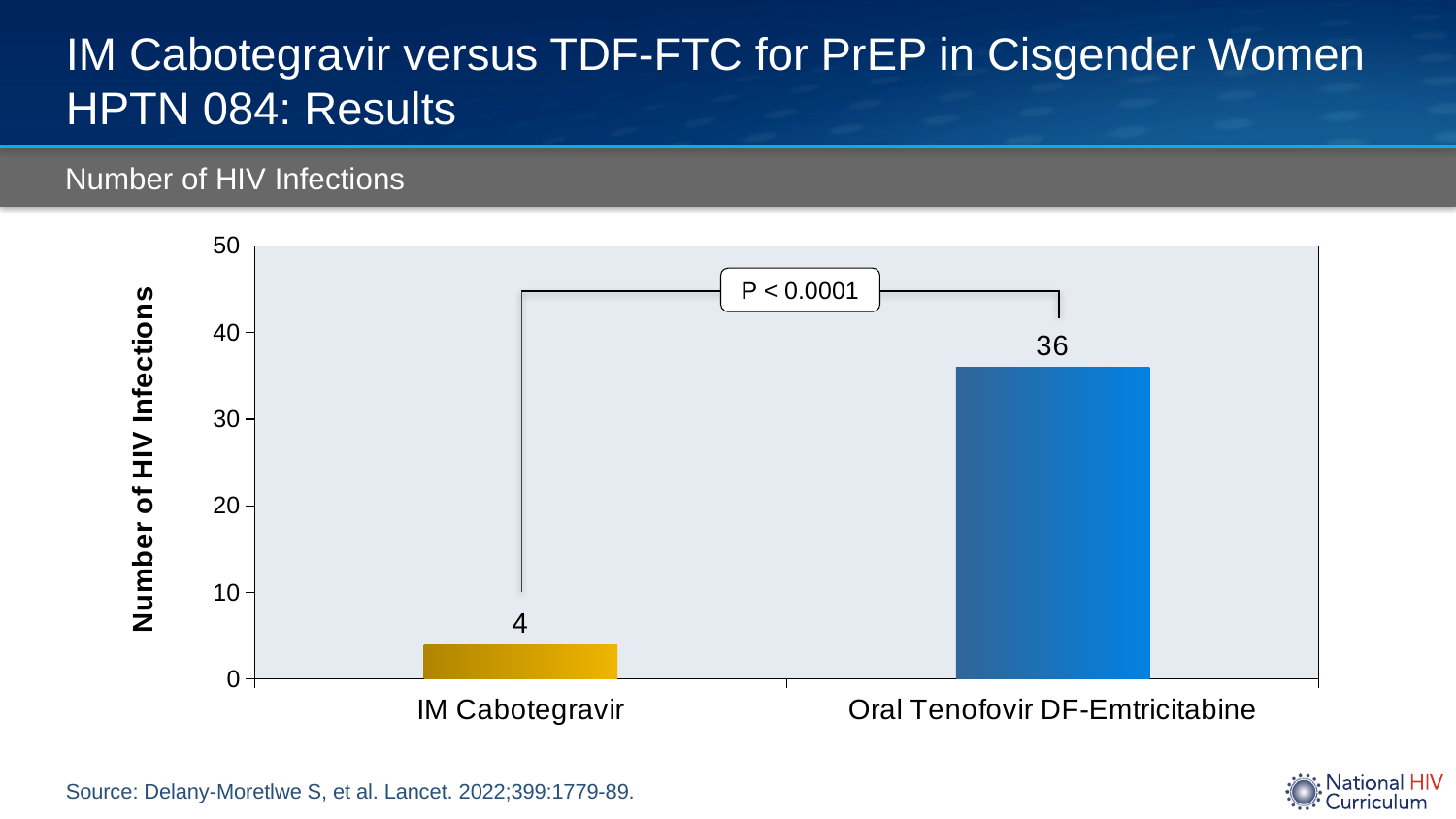
Which group had the lowest number of HIV infections? IM Cabotegravir What is the difference in the number of HIV infections between Oral Tenofovir DF-Emtricitabine and IM Cabotegravir? 32 How many categories are shown on the x axis of the chart? 2 What kind of chart is shown on the slide? Bar chart What is the label of the y axis of the chart? Number of HIV Infections Which had more HIV infections, IM Cabotegravir or Oral Tenofovir DF-Emtricitabine? Oral Tenofovir DF-Emtricitabine What is the number of HIV infections for Oral Tenofovir DF-Emtricitabine? 36 Is the number of HIV infections for Oral Tenofovir DF-Emtricitabine greater or less than 30? greater Is the number of HIV infections for IM Cabotegravir greater or less than 10? less What P value is shown on the chart comparing the two groups? P < 0.0001 Which group had the highest number of HIV infections? Oral Tenofovir DF-Emtricitabine What is the number of HIV infections for IM Cabotegravir? 4